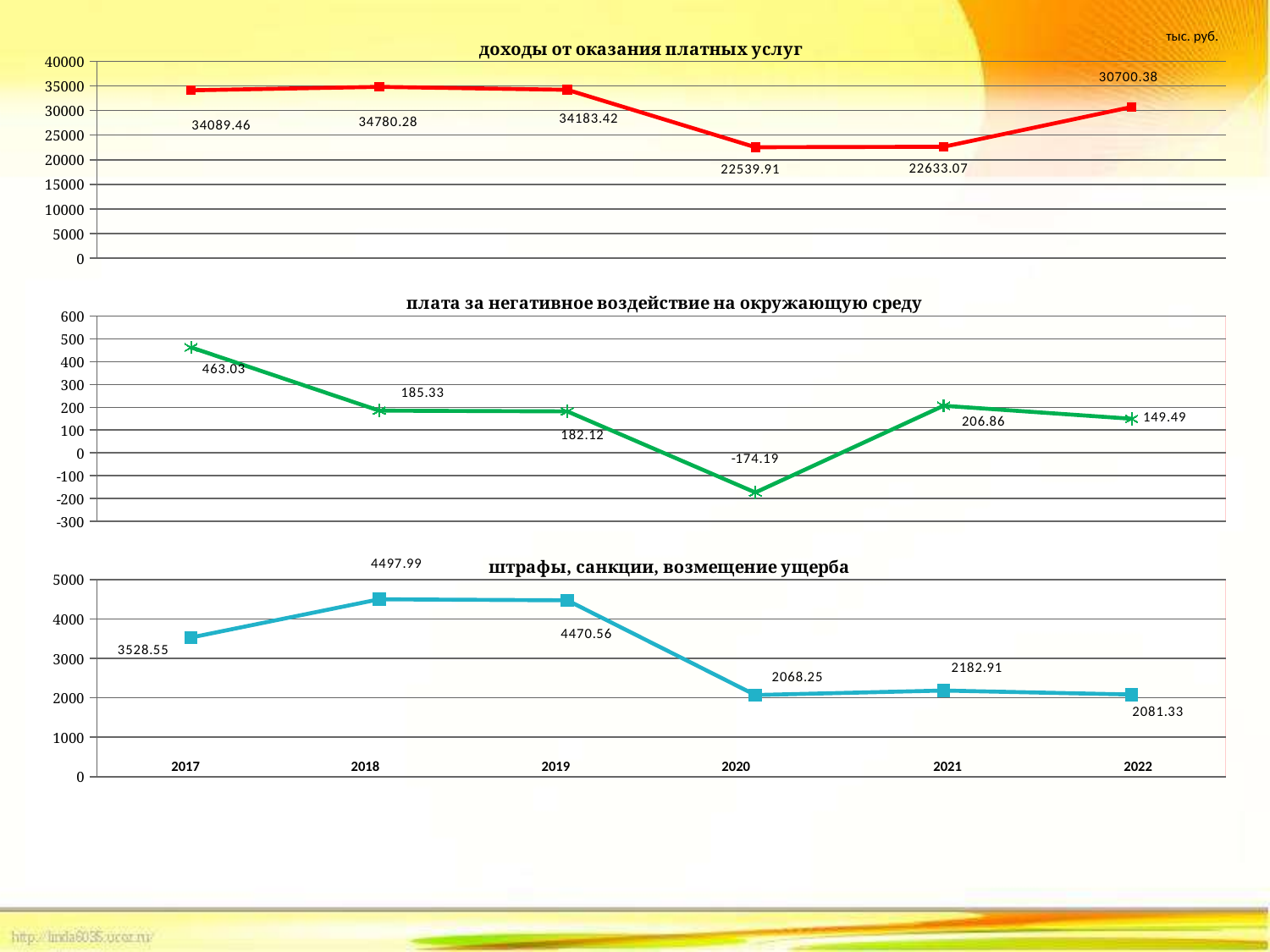
In the chart titled 'штрафы, санкции, возмещение ущерба', which is larger, the value for 2021 or the value for 2022? 2021 In the chart titled 'доходы от оказания платных услуг', what is the value for 2022? 30700.38 In the chart titled 'штрафы, санкции, возмещение ущерба', how many years are plotted? 6 What kind of chart is the bottom chart titled 'штрафы, санкции, возмещение ущерба'? line chart In the chart titled 'плата за негативное воздействие на окружающую среду', which year has the lowest value? 2020 In the chart titled 'доходы от оказания платных услуг', which year has the lowest value? 2020 In the chart titled 'доходы от оказания платных услуг', which year has the highest value? 2018 In the chart titled 'штрафы, санкции, возмещение ущерба', what is the difference between the 2018 value and the 2019 value? 27.43 In the chart titled 'доходы от оказания платных услуг', is the value for 2020 greater or less than 25000? less In the chart titled 'плата за негативное воздействие на окружающую среду', which year has the highest value? 2017 In the chart titled 'доходы от оказания платных услуг', what is the difference between the 2018 value and the 2017 value? 690.82 In the chart titled 'плата за негативное воздействие на окружающую среду', what is the value for 2020? -174.19